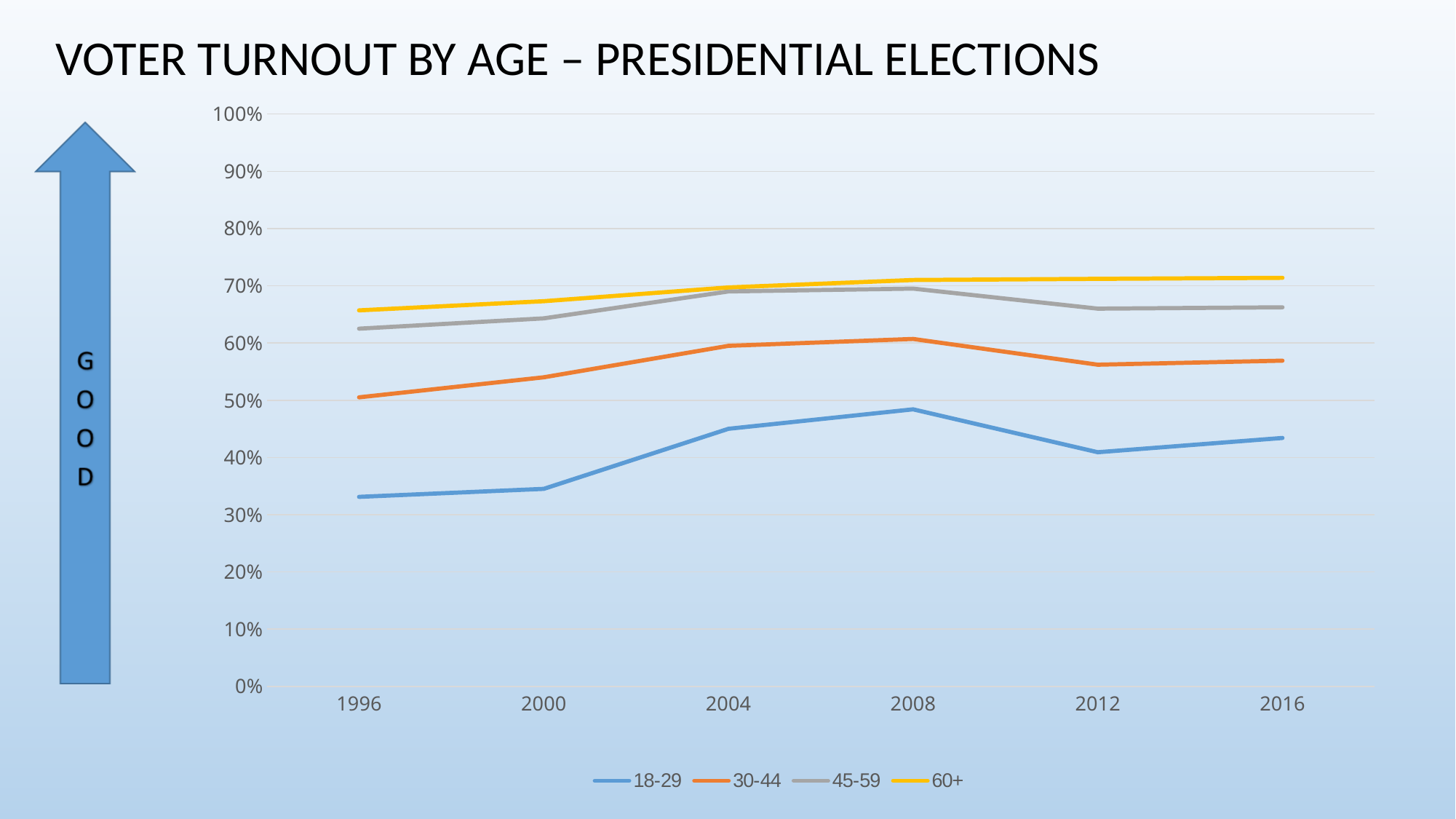
In which year is the 18-29 series at its lowest? 1996 Which age group has the lowest turnout in 1996? 18-29 Is the value for 18-29 in 1996 greater or less than 40%? less Is the value for 60+ in 2016 greater or less than 70%? greater How many series does the legend list? 4 In which year does the 18-29 series reach its highest value? 2008 Which age group has the highest turnout in 2016? 60+ How many election years are plotted along the x axis? 6 Is the value for 30-44 in 1996 greater or less than 60%? less Which is larger for the 18-29 series: the value in 2000 or the value in 2004? 2004 Does the 18-29 series rise or fall from 1996 to 2008? rise What kind of chart is shown on the slide? line chart